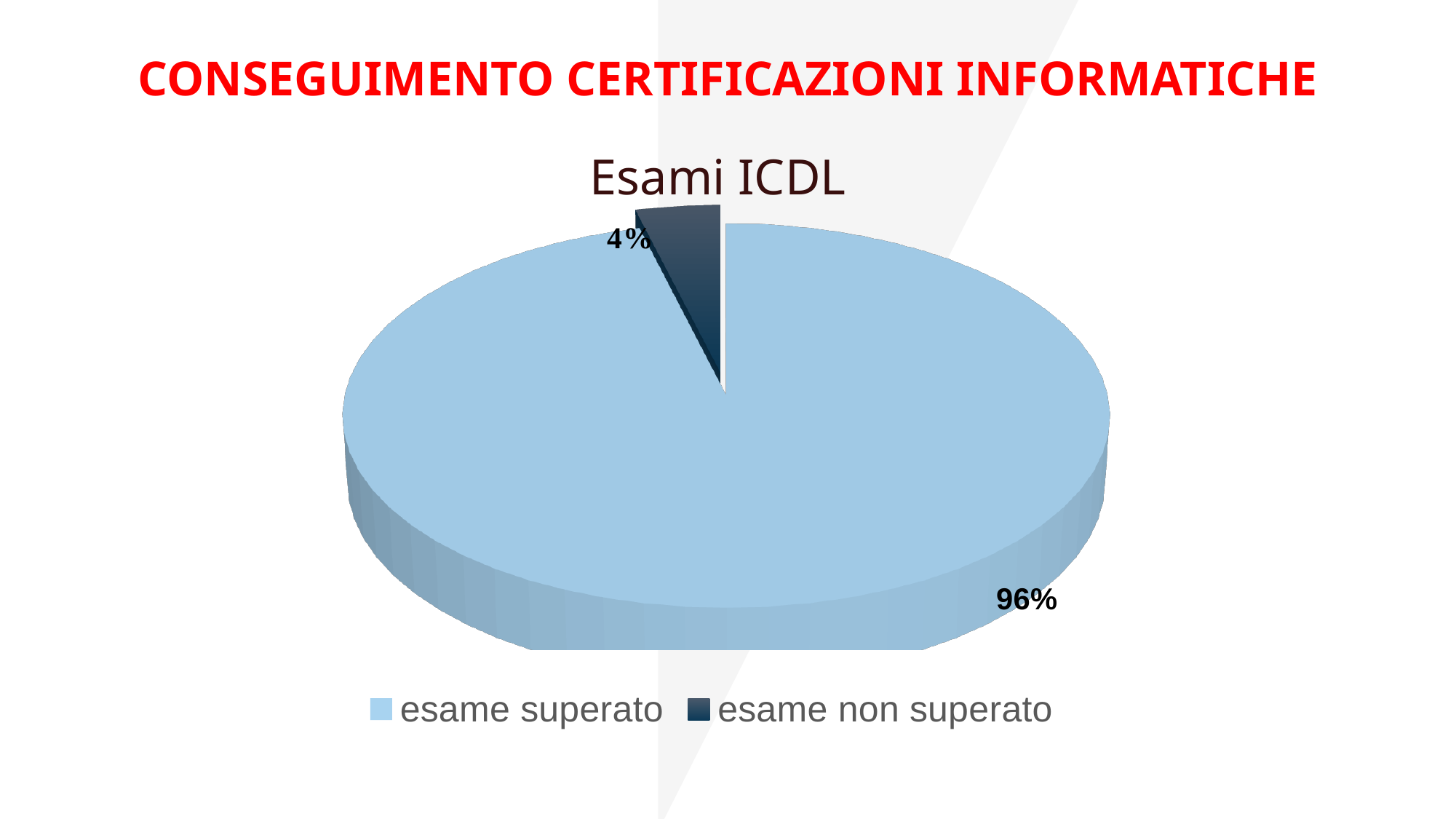
What is the share of the pie taken by 'esame superato'? 96% What percentage of the pie is 'esame non superato'? 4% What is the title of the chart? Esami ICDL Which slice is the smallest? esame non superato Which slice is the largest? esame superato What kind of chart is shown on the slide? pie chart Which is larger, 'esame superato' or 'esame non superato'? esame superato How many entries does the legend list? 2 What colour is the 'esame non superato' slice? dark blue How many slices does the pie chart have? 2 What is the difference in percentage points between 'esame superato' and 'esame non superato'? 92 What percentage of the pie is 'esame superato'? 96%